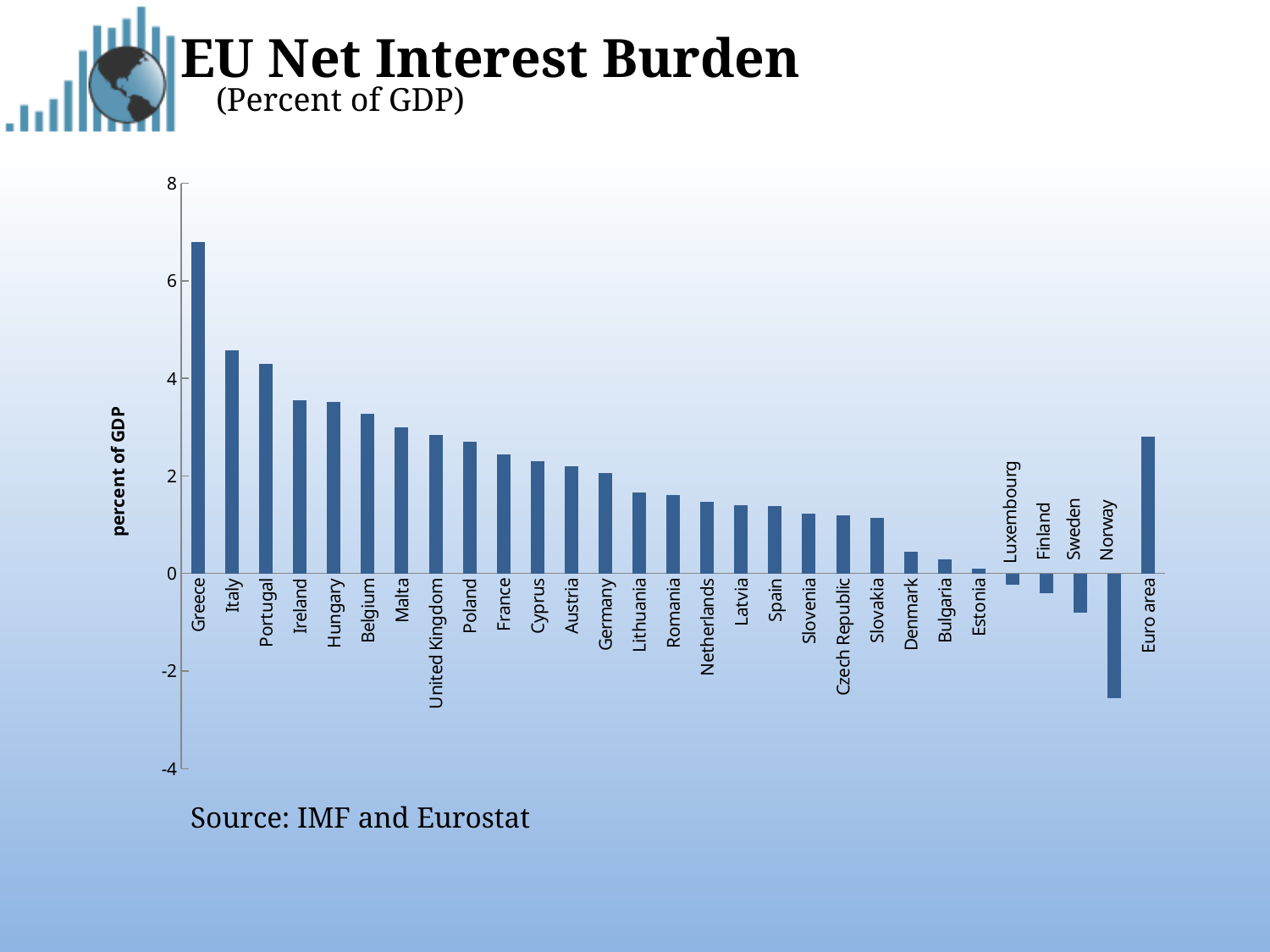
Which has a larger net interest burden, Spain or Sweden? Spain How many bars are plotted in the chart? 29 Is the value for Italy greater or less than 4? greater Is the value for Denmark greater or less than 2? less Which has a larger net interest burden, Portugal or Belgium? Portugal Which country has the highest net interest burden in the chart? Greece Is the value for Euro area greater or less than 2? greater What is the label on the vertical axis of the chart? percent of GDP Which country has the lowest net interest burden in the chart? Norway What kind of chart is shown on the slide? bar chart